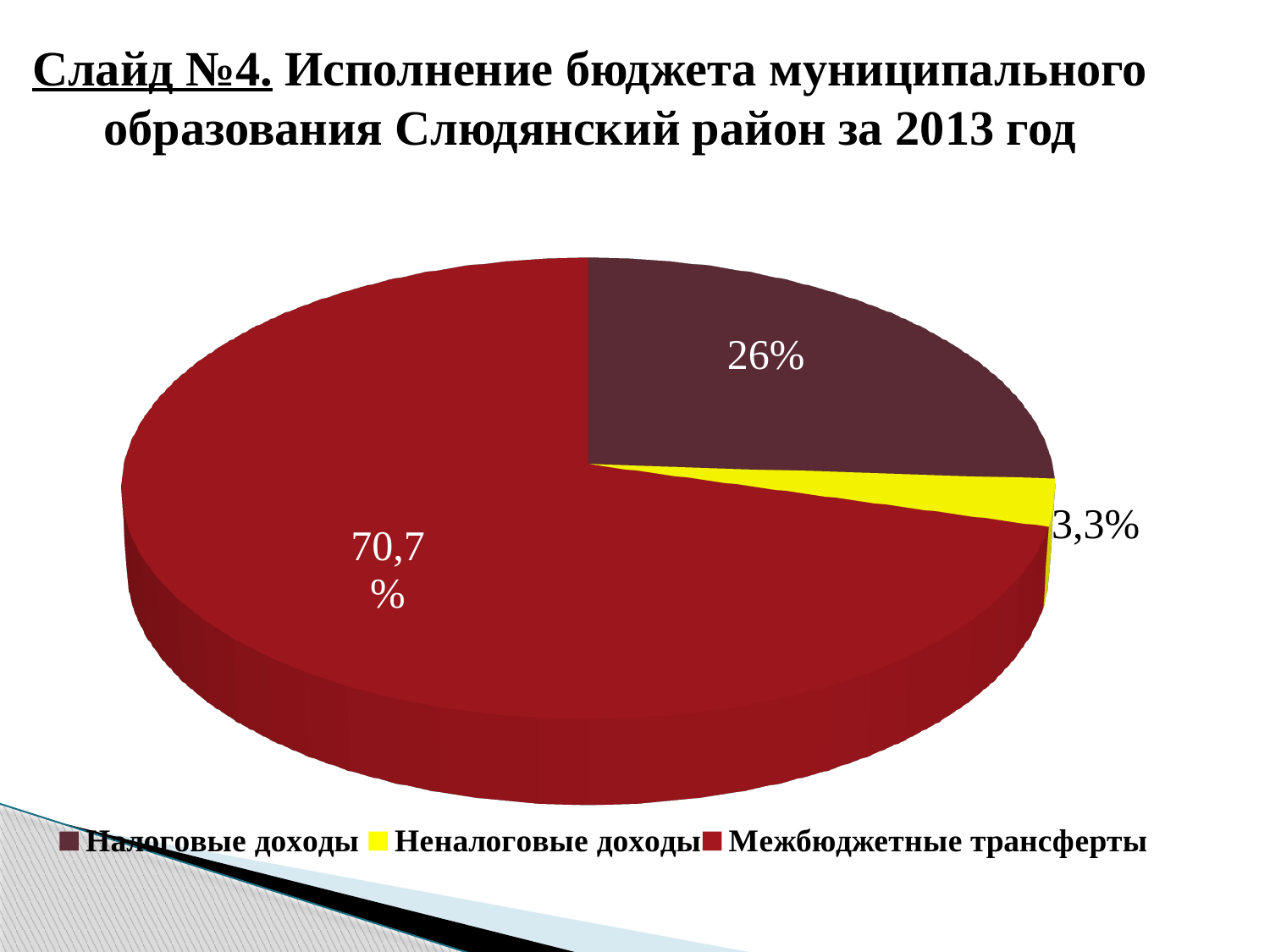
How many entries does the legend list? 3 How many slices does the pie chart have? 3 What share of the pie does Неналоговые доходы have? 3,3% What is the difference in percentage points between Налоговые доходы and Неналоговые доходы? 22,7 What colour is the slice for Неналоговые доходы? yellow Which category has the smallest slice of the pie? Неналоговые доходы Which is larger, Налоговые доходы or Неналоговые доходы? Налоговые доходы What share of the pie does Межбюджетные трансферты have? 70,7% What share of the pie does Налоговые доходы have? 26% What kind of chart is shown on the slide? pie chart What is the difference in percentage points between Межбюджетные трансферты and Налоговые доходы? 44,7 Which category has the largest slice of the pie? Межбюджетные трансферты